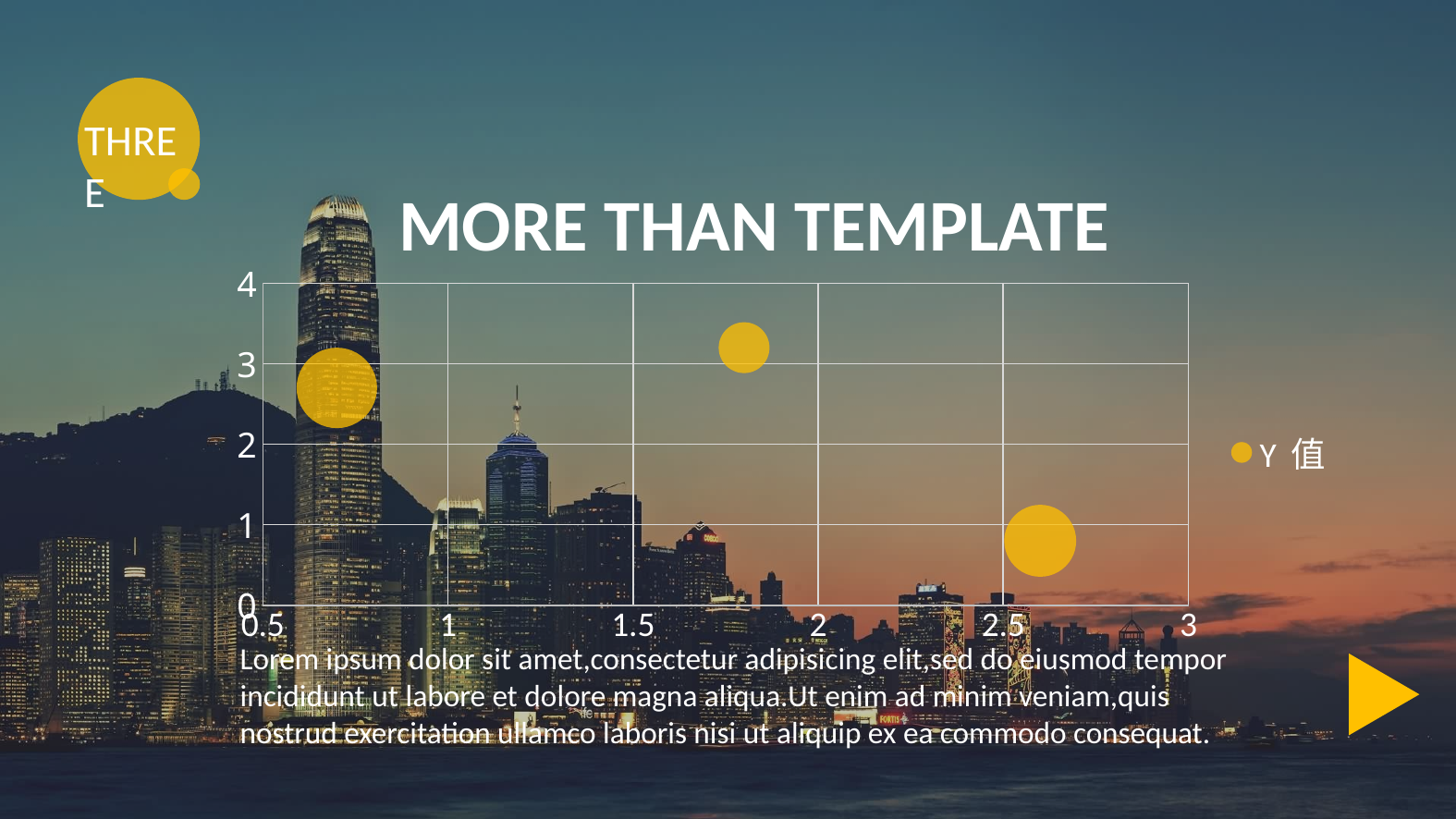
How many series does the chart legend list? 1 Is the y value of the leftmost bubble greater or less than 2? greater What is the title shown above the chart? MORE THAN TEMPLATE What kind of chart is shown on the slide? bubble chart Which bubble has the lowest y value: the leftmost, the middle, or the rightmost? the rightmost Is the x value of the leftmost bubble greater or less than 1? less What is the legend entry shown to the right of the chart? Y 值 Which bubble has the highest y value: the leftmost, the middle, or the rightmost? the middle Is the x value of the rightmost bubble greater or less than 2.5? greater How many bubbles are plotted on the chart? 3